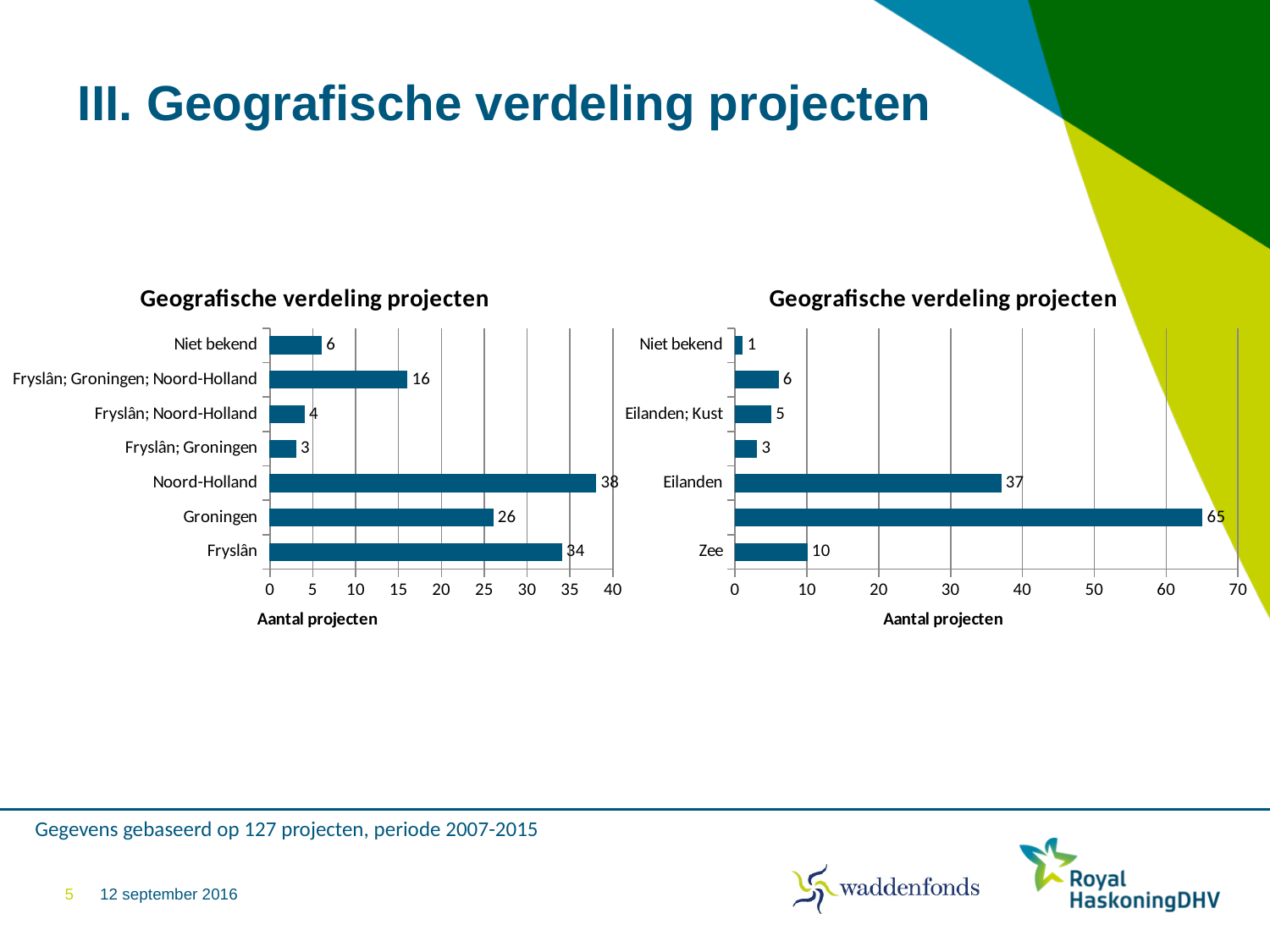
What is the x-axis label of the left chart? Aantal projecten In the left chart, how many projects are shown for Noord-Holland? 38 In the left chart, what is the value for Groningen? 26 What type of chart is the right chart? Bar chart In the left chart, which category has the highest number of projects? Noord-Holland In the left chart, which is larger: the value for Fryslân or the value for Groningen? Fryslân In the right chart, how many projects are shown for Eilanden? 37 In the right chart, which labelled category has the lowest value? Niet bekend In the left chart, what is the difference between the values for Noord-Holland and Fryslân? 4 How many categories are shown in the left chart? 7 In the right chart, what is the value for Zee? 10 In the left chart, which category has the lowest number of projects? Fryslân; Groningen